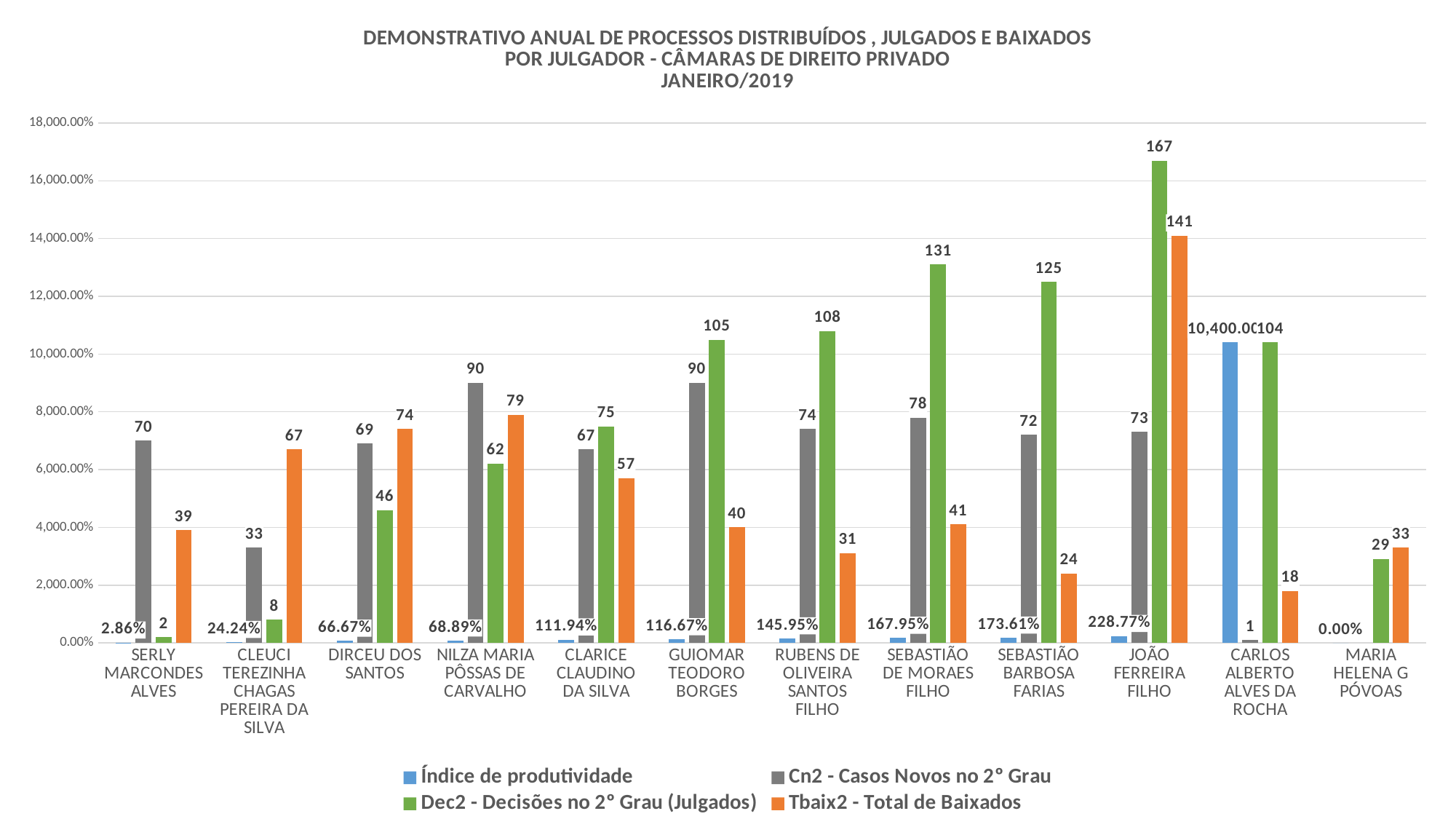
Which colour represents the Tbaix2 - Total de Baixados series? Orange How many judges are shown on the x axis? 12 What kind of chart is shown on the slide? Bar chart Which judge has the lowest Tbaix2 - Total de Baixados value? CARLOS ALBERTO ALVES DA ROCHA What is the Dec2 - Decisões no 2° Grau (Julgados) value for JOÃO FERREIRA FILHO? 167 Which judge has the highest Dec2 - Decisões no 2° Grau (Julgados) value? JOÃO FERREIRA FILHO What is the Índice de produtividade for SEBASTIÃO BARBOSA FARIAS? 173.61% What is the Tbaix2 - Total de Baixados value for NILZA MARIA PÔSSAS DE CARVALHO? 79 What is the difference between the Cn2 and Dec2 values for SERLY MARCONDES ALVES? 68 Which is larger for RUBENS DE OLIVEIRA SANTOS FILHO: the Cn2 value or the Dec2 value? Dec2 What is the Cn2 - Casos Novos no 2° Grau value for GUIOMAR TEODORO BORGES? 90 How many series does the legend list? 4